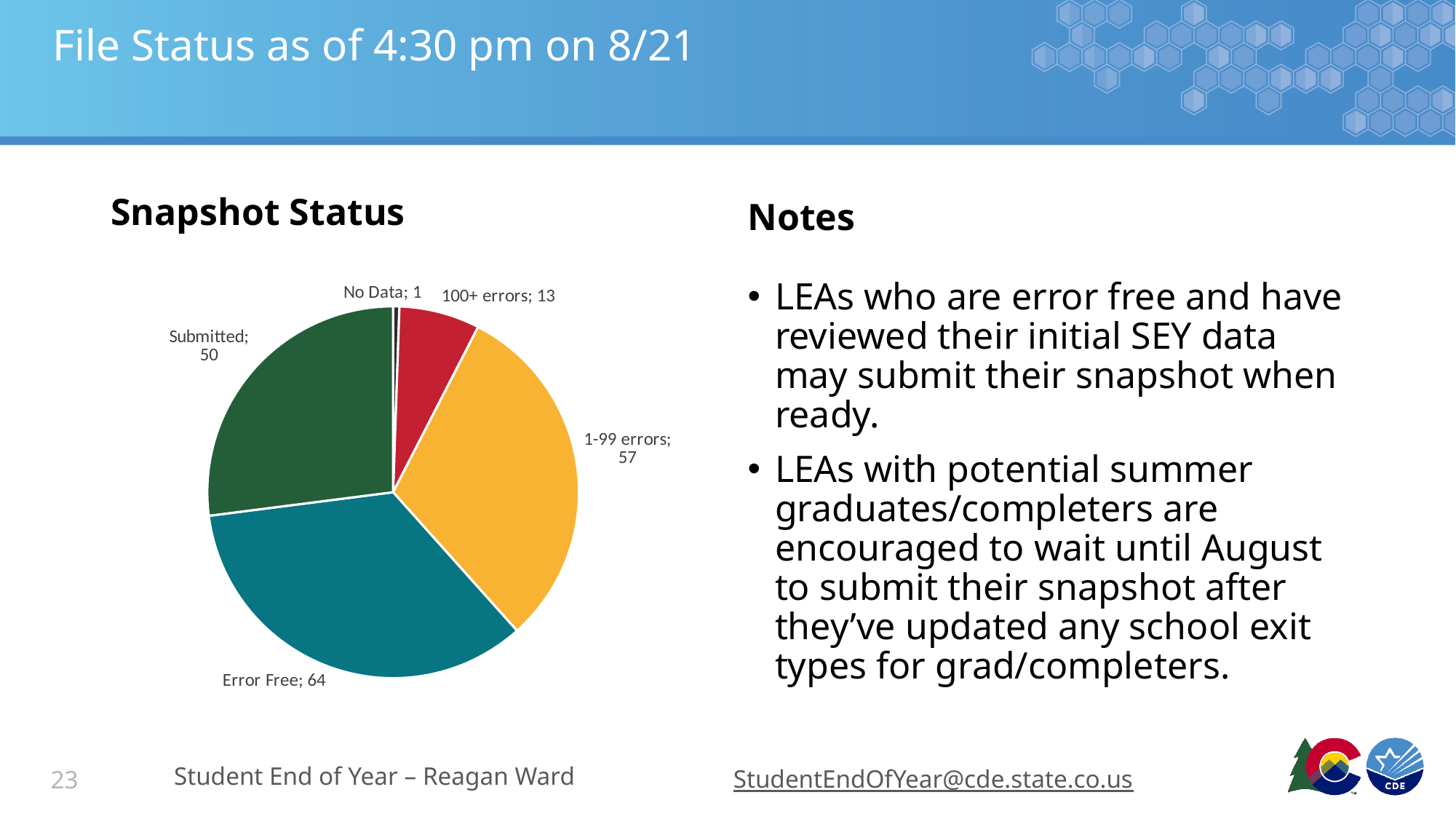
What is the difference between the Error Free value and the Submitted value? 14 What is the value for 100+ errors? 13 Which category has the largest slice of the pie? Error Free What is the value for Submitted? 50 Which is larger, the value for 1-99 errors or the value for 100+ errors? 1-99 errors What is the value for 1-99 errors? 57 What is the value for No Data? 1 How many slices does the Snapshot Status pie chart have? 5 What is the value for Error Free? 64 What type of chart is shown on the slide? pie chart What is the title of the chart? Snapshot Status Which category has the smallest slice of the pie? No Data